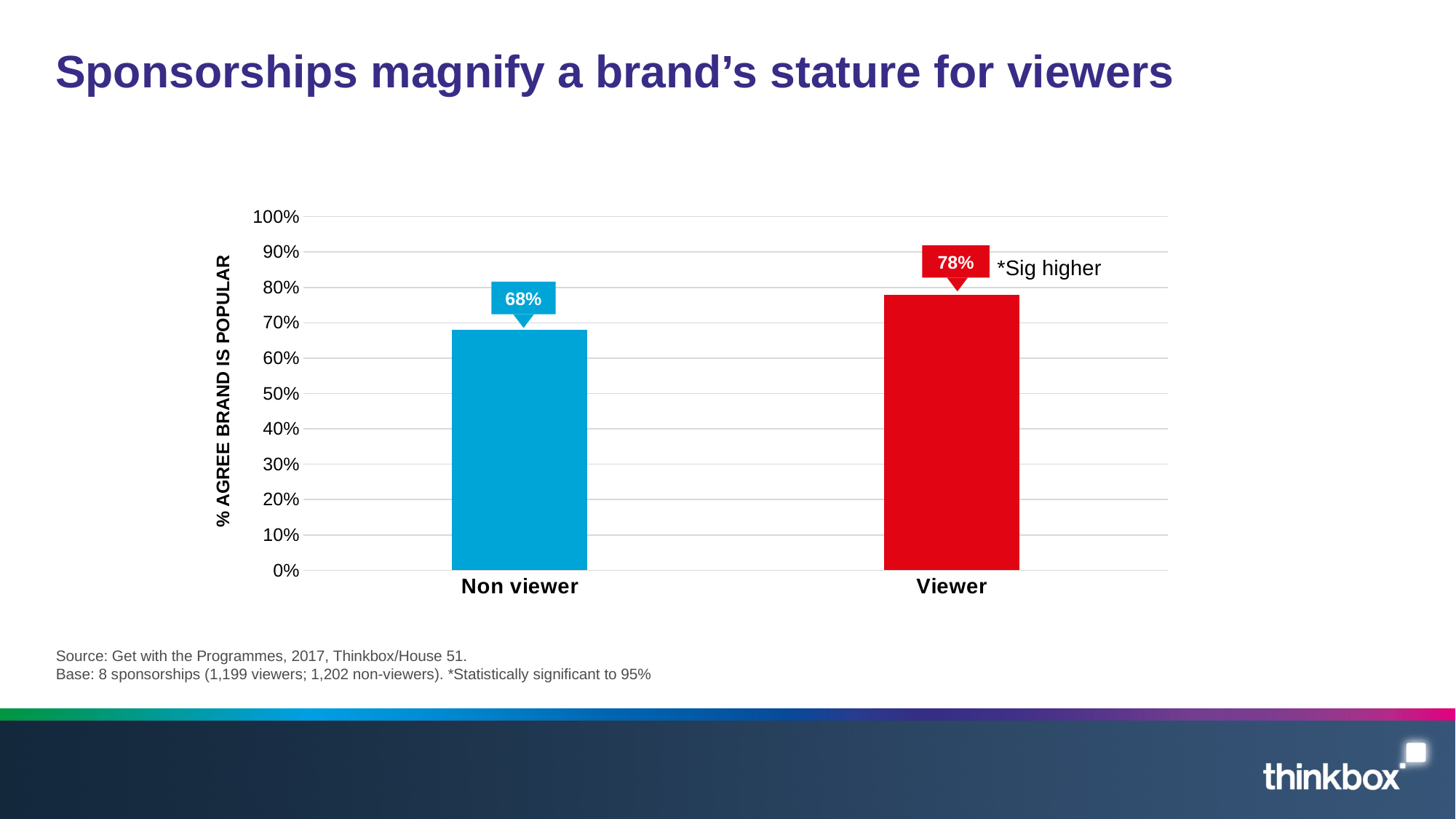
What is the difference between the Viewer and Non viewer values? 10% What is the value for Non viewer? 68% What kind of chart is shown on the slide? bar chart How many categories are shown on the x axis? 2 Which category has the lowest value? Non viewer What is the value for Viewer? 78% What colour is the Viewer bar? red What is the label on the vertical axis? % AGREE BRAND IS POPULAR Which category has the highest value? Viewer Is the value for Non viewer greater or less than 70%? less Which is larger, the value for Viewer or the value for Non viewer? Viewer Is the value for Viewer greater or less than 70%? greater